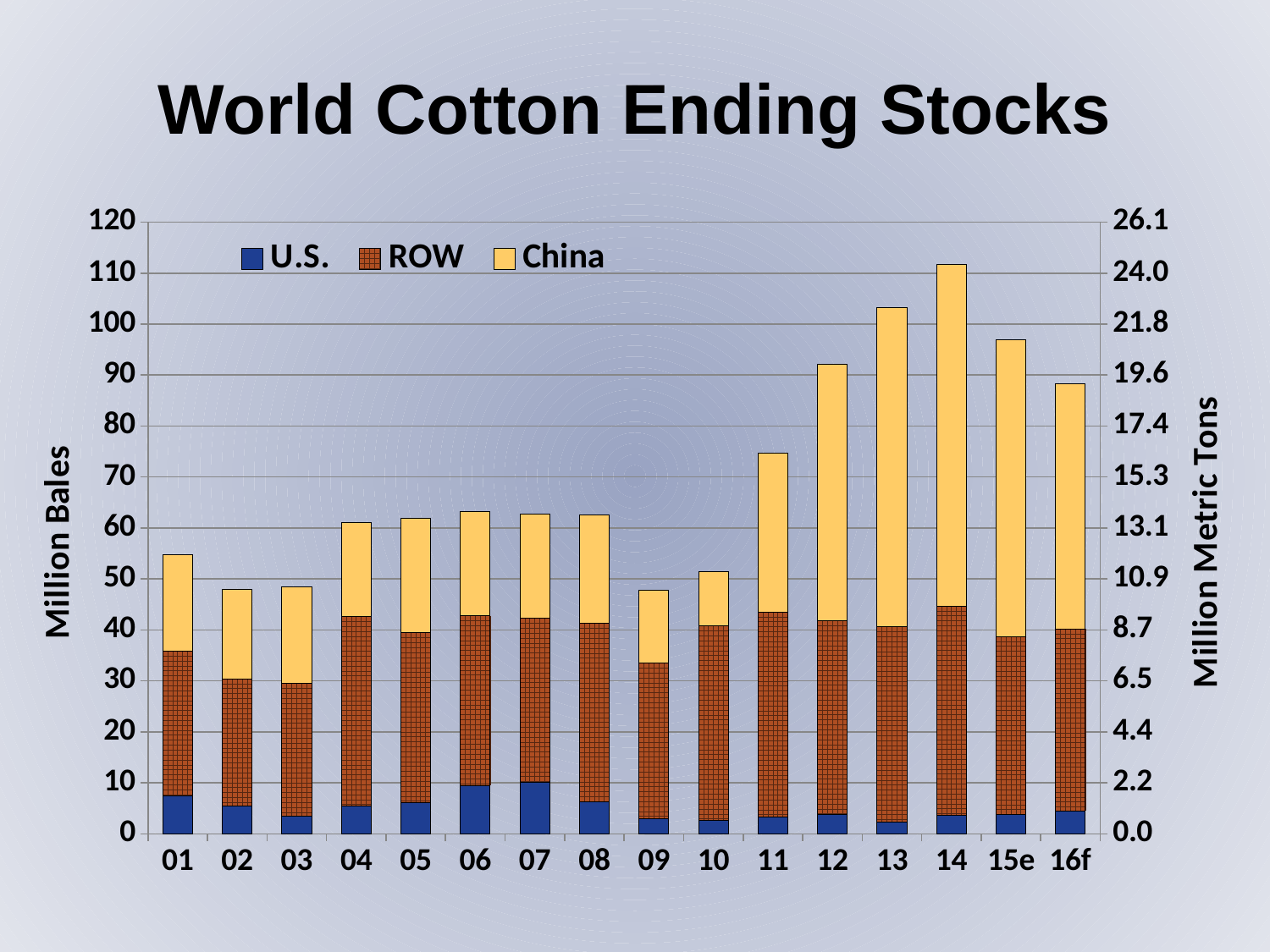
Which year has the larger total ending stock, 01 or 02? 01 Do total ending stocks rise or fall from 10 to 14? rise What is the title of the left vertical axis? Million Bales How many years (categories) are shown along the x axis? 16 What kind of chart is shown on the slide? Stacked bar chart Is the total ending stock for 16f greater or less than 100 million bales? less Which year has the highest total world cotton ending stocks? 14 Is the total ending stock for 11 greater or less than 70 million bales? greater Is the total ending stock for 01 greater or less than 60 million bales? less Which year has the larger total ending stock, 13 or 14? 14 How many series does the legend list? 3